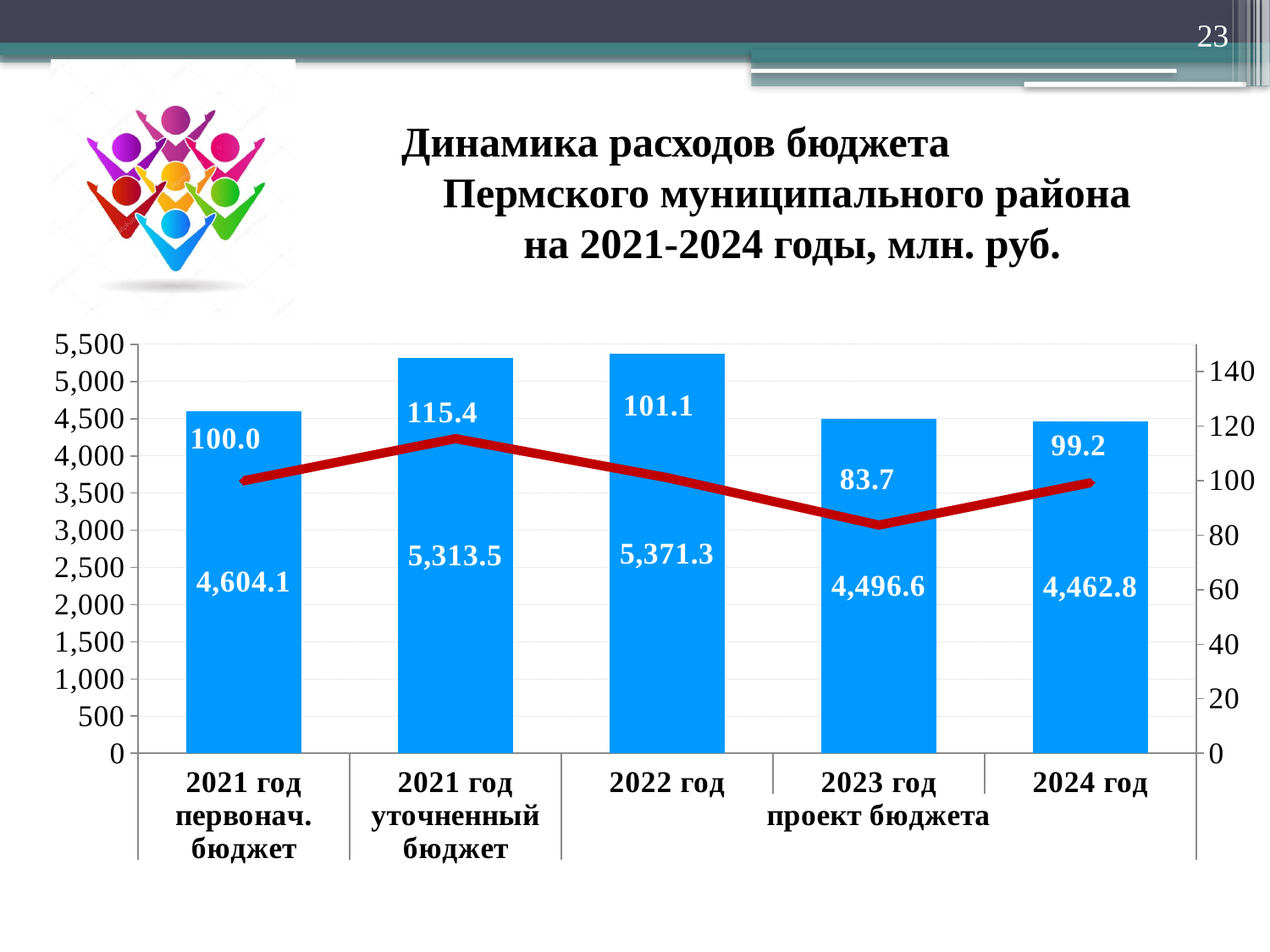
What is the title of the chart? Динамика расходов бюджета Пермского муниципального района на 2021-2024 годы, млн. руб. Which category has the lowest bar value? 2024 год What is the line value (right axis) for 2023 год? 83.7 Which category has the highest bar value? 2022 год How many categories are shown on the x axis? 5 Which is larger, the bar value for 2023 год or for 2024 год? 2023 год What is the line value (right axis) for 2021 год уточненный бюджет? 115.4 Do the bar values rise or fall from 2022 год to 2024 год? Fall What kind of chart is shown on the slide? Combined bar and line chart What is the bar value for 2021 год первонач. бюджет? 4,604.1 What is the difference between the bar values for 2021 год уточненный бюджет and 2021 год первонач. бюджет? 709.4 What is the bar value for 2022 год? 5,371.3